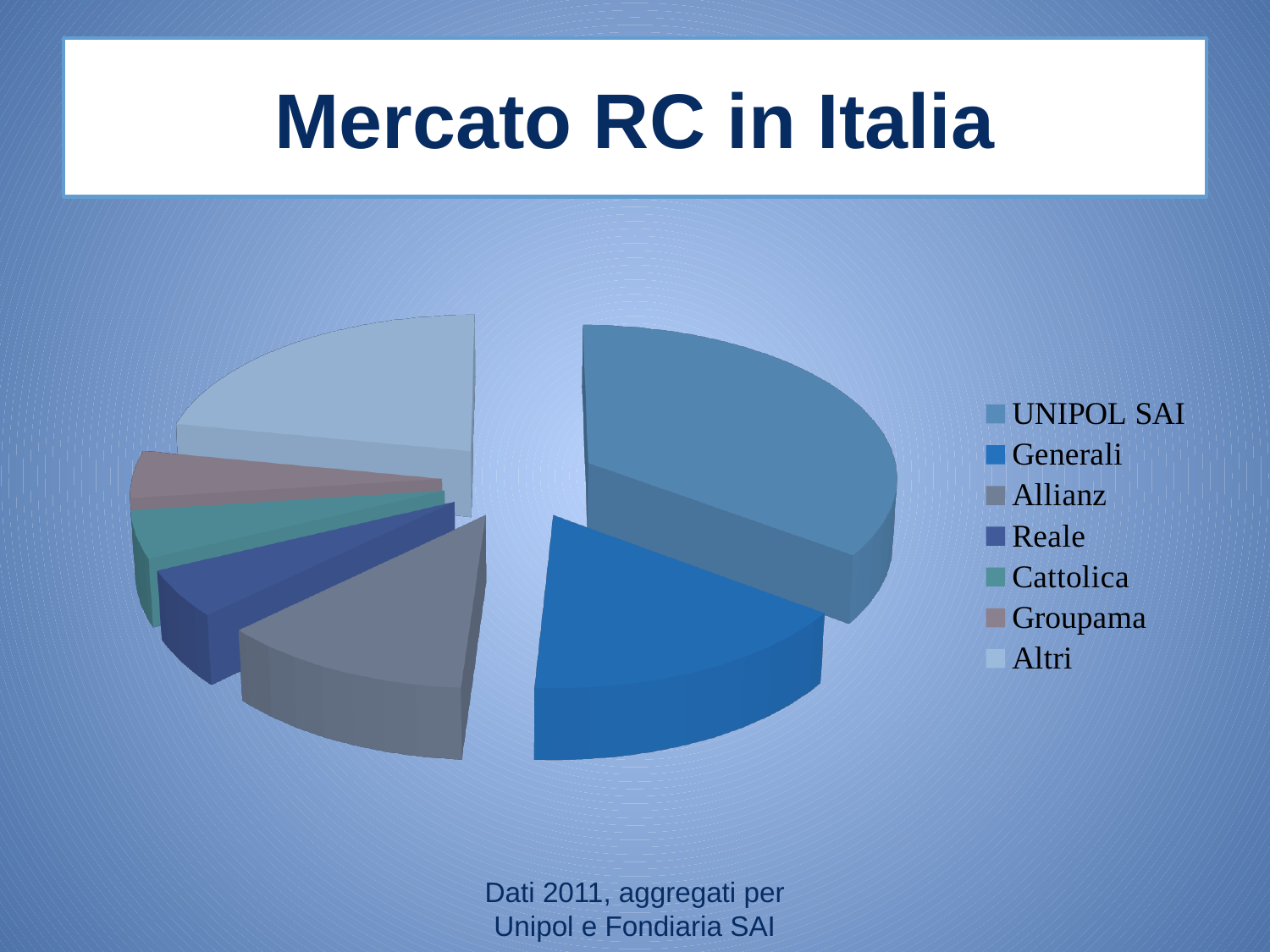
Which slice is larger, Allianz or Groupama? Allianz How many slices does the pie chart have? 7 What is the title of the slide containing the pie chart? Mercato RC in Italia What kind of chart is shown on the slide? pie chart Which slice is larger, Altri or Reale? Altri Which slice is larger, UNIPOL SAI or Cattolica? UNIPOL SAI Which category has the largest slice in the pie chart? UNIPOL SAI Which legend entry is listed last in the pie chart's legend? Altri How many entries does the legend of the pie chart list? 7